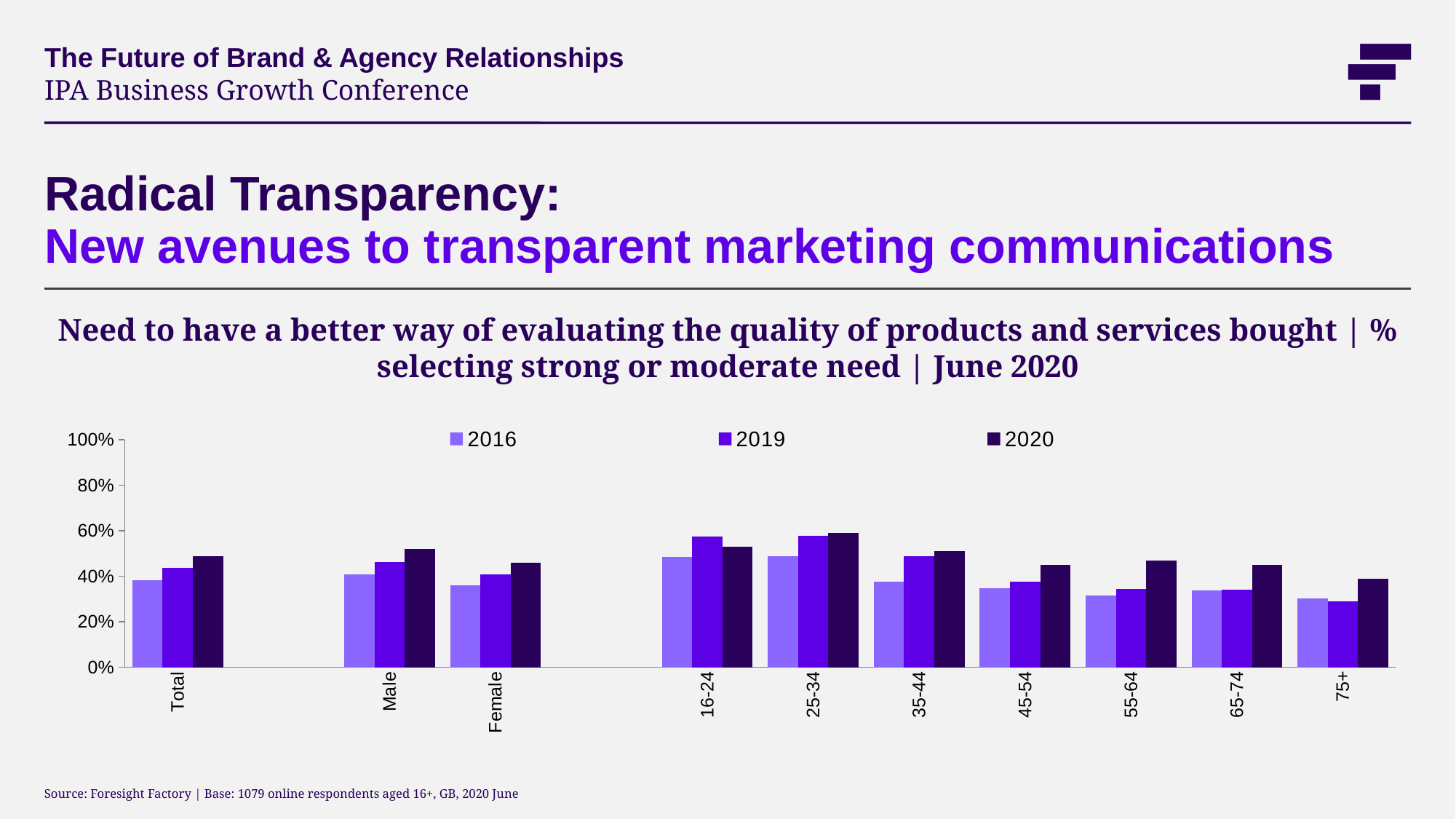
How many categories are shown along the x axis? 10 How many series does the legend list? 3 Which series is shown in the darkest colour in the legend? 2020 Is the 2016 value for Female greater or less than 40%? less Among the age groups, which has the lowest 2020 value? 75+ For the Total category, do the values rise or fall from 2016 to 2020? rise Is the 2019 value for 16-24 greater or less than 40%? greater What type of chart is shown on the slide? bar chart Among the age groups, which has the highest 2020 value? 25-34 Which is larger for 2020: Male or Female? Male Is the 2016 value for 75+ greater or less than 40%? less